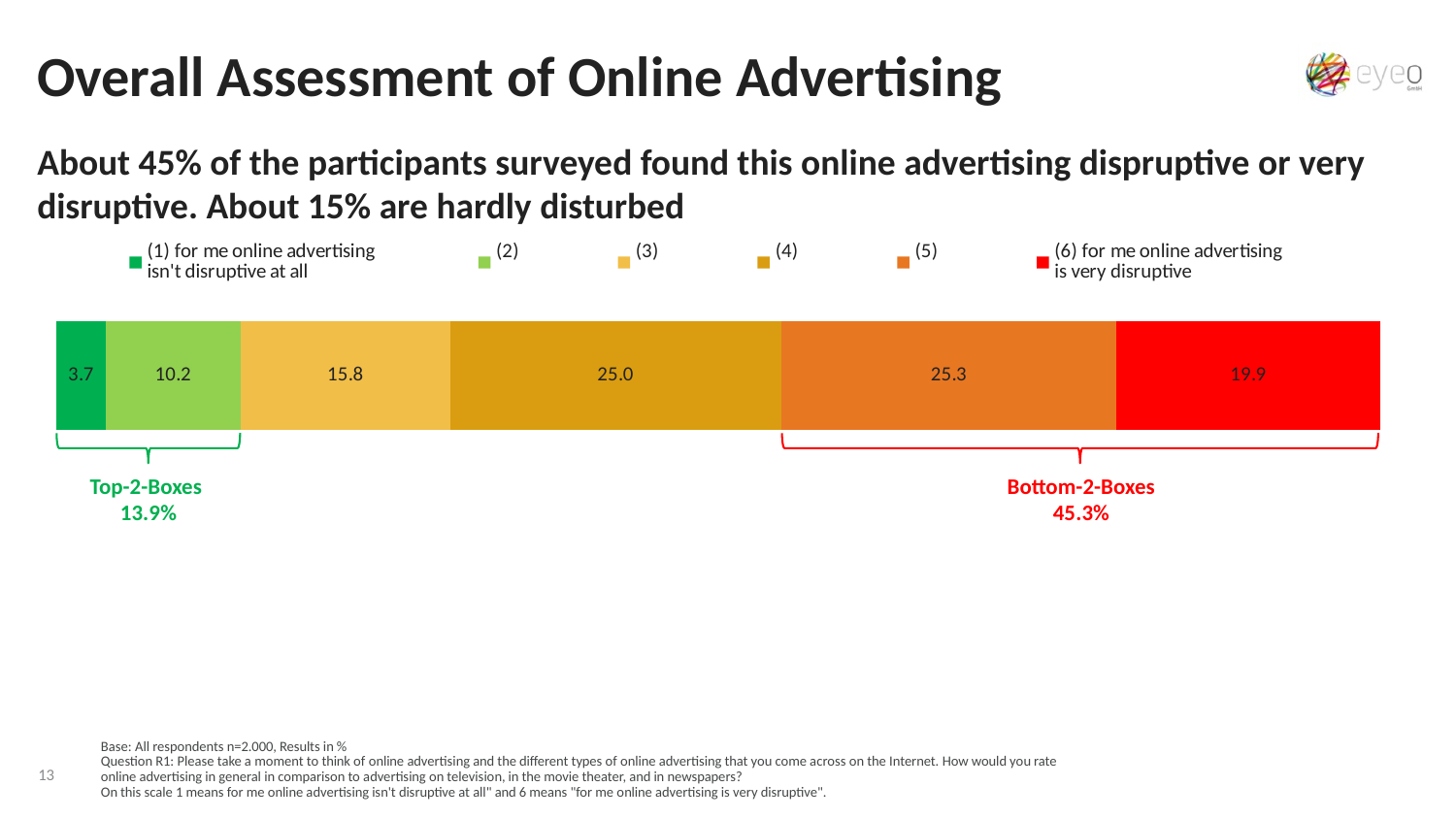
What kind of chart is shown on the slide? Stacked bar chart Which is larger, the value for segment (2) or the value for segment (3)? (3) What is the total of the segments (1) and (2), labelled Top-2-Boxes? 13.9% What is the total of the segments (5) and (6), labelled Bottom-2-Boxes? 45.3% What value is shown for the segment '(6) for me online advertising is very disruptive'? 19.9 What value is shown for the segment '(4)'? 25.0 What is the difference between the values for segment (5) and segment (6)? 5.4 Which segment of the bar has the highest value? (5) How many series does the legend list? 6 What value is shown for the segment '(1) for me online advertising isn't disruptive at all'? 3.7 What colour is the segment for '(6) for me online advertising is very disruptive'? Red Which segment of the bar has the lowest value? (1) for me online advertising isn't disruptive at all